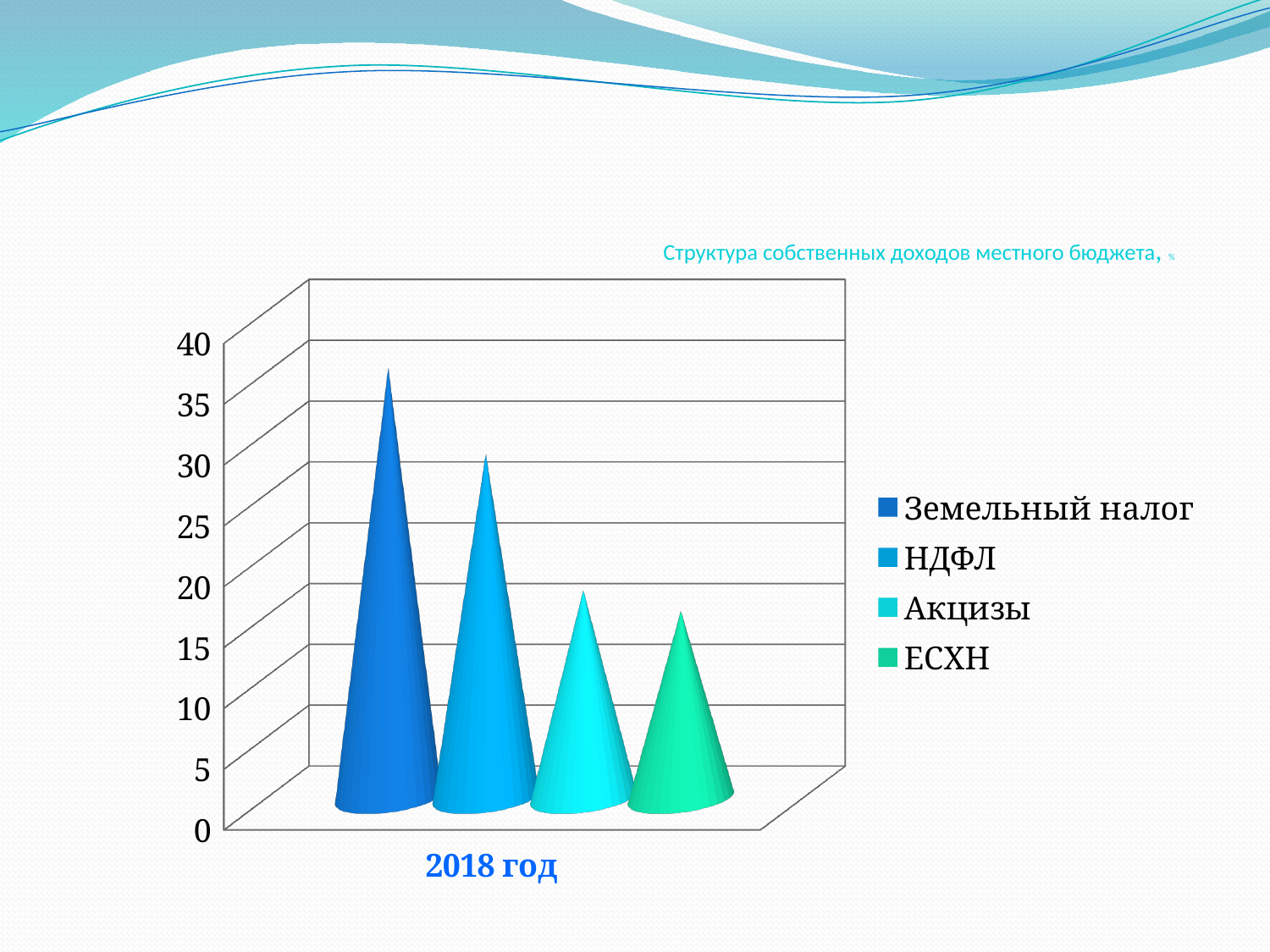
Which series has the lowest value for 2018 год? ЕСХН How many categories are shown on the x axis? 1 Is the value for Земельный налог greater or less than 30? greater What kind of chart is shown on the slide? bar chart What is the title of the chart? Структура собственных доходов местного бюджета, % Which series has the highest value for 2018 год? Земельный налог Which is larger for 2018 год, Акцизы or ЕСХН? Акцизы How many series does the legend list? 4 Which is larger for 2018 год, Земельный налог or НДФЛ? Земельный налог Is the value for НДФЛ greater or less than 35? less Is the value for ЕСХН greater or less than 25? less